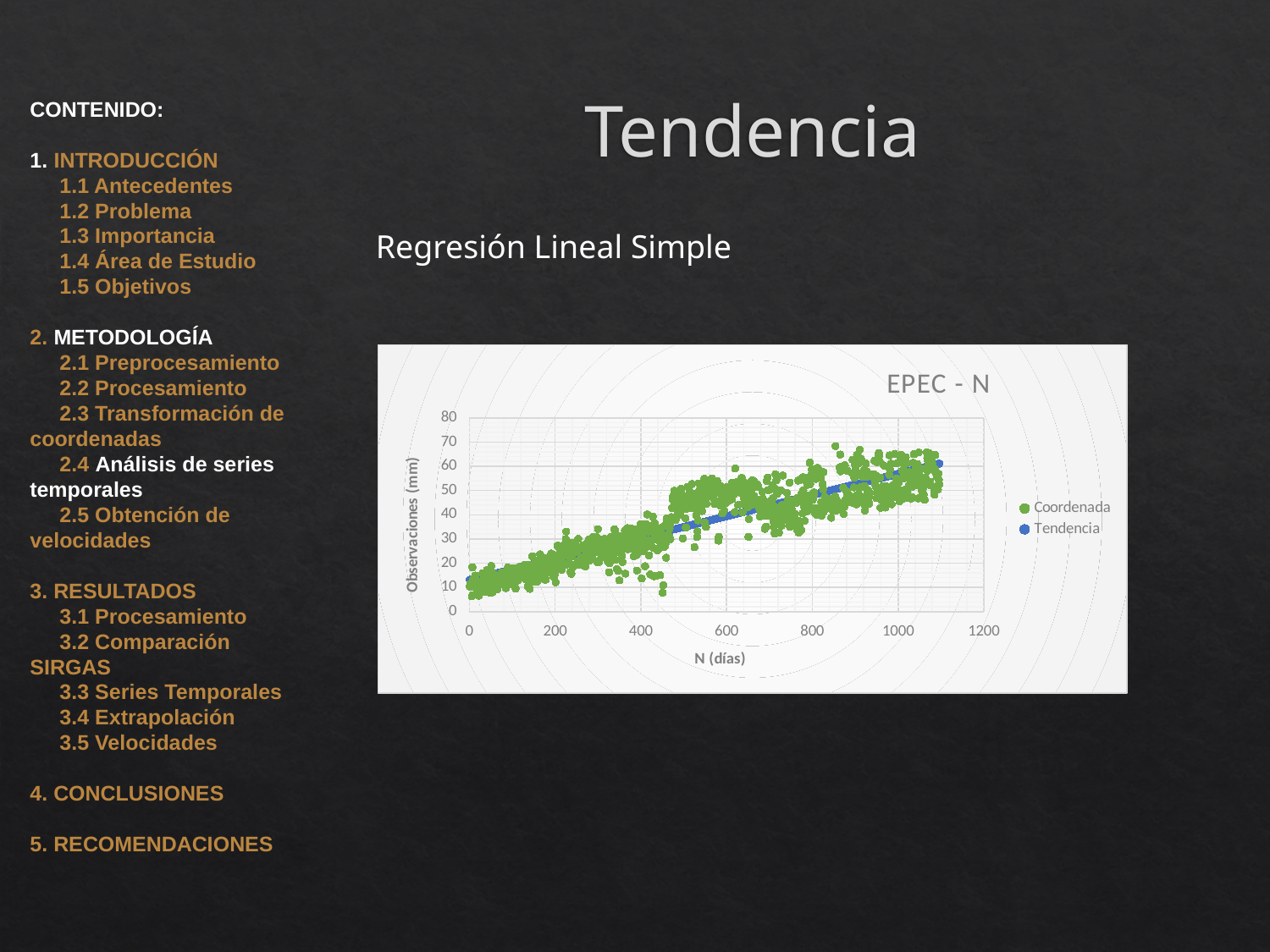
Which series in the EPEC - N chart is plotted in green? Coordenada In the EPEC - N chart, are the Coordenada values near N = 1000 días greater or less than 40 mm? greater Do the Coordenada values in the EPEC - N chart rise or fall as N (días) increases? rise What is the title of the chart on the slide? EPEC - N In the EPEC - N chart, which is larger: the Coordenada values near N = 200 días or near N = 800 días? near N = 800 días How many series does the legend of the EPEC - N chart list? 2 In the EPEC - N chart, is the Tendencia value near N = 1000 días greater or less than 40 mm? greater In the EPEC - N chart, are the Coordenada values near N = 0 días greater or less than 20 mm? less What kind of chart is shown on the slide? scatter chart Does the Tendencia line in the EPEC - N chart rise or fall along the x axis? rise